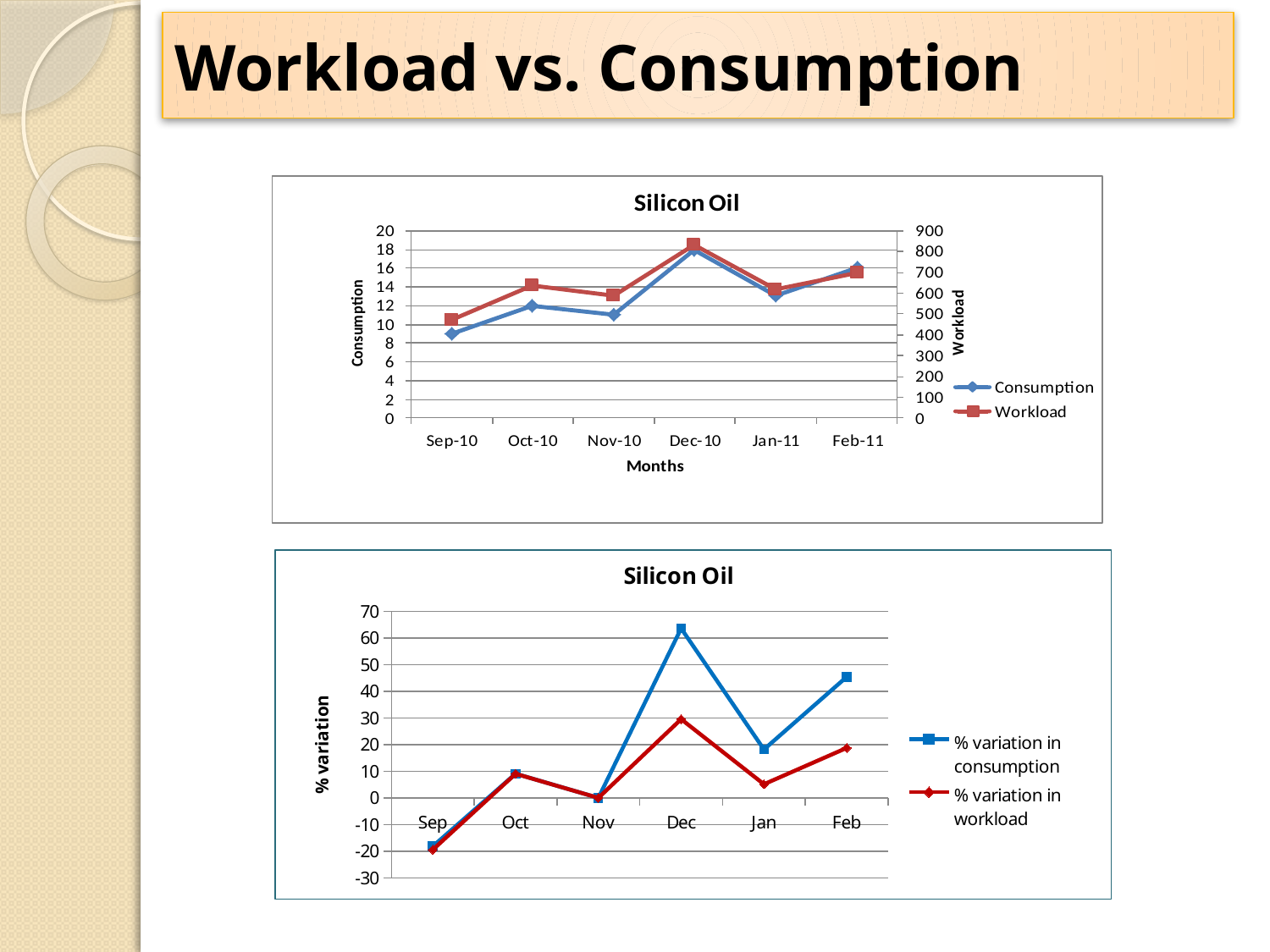
In the top chart, in which month is Consumption highest? Dec-10 What kind of chart is the top chart on the slide? line chart In the top chart, is Consumption higher in Oct-10 or in Jan-11? Jan-11 In the top chart, is the Consumption value for Dec-10 greater or less than 16? greater In the bottom chart, which series has the larger value in Feb, % variation in consumption or % variation in workload? % variation in consumption What is the label of the right-hand vertical axis of the top chart? Workload In the top chart, in which month is Workload lowest? Sep-10 How many months are plotted on the x axis of the top chart? 6 In the top chart, is the Workload value for Sep-10 greater or less than 500? less In the bottom chart, is the % variation in consumption for Dec greater or less than 60? greater In the bottom chart, in which month is the % variation in consumption highest? Dec How many series does the legend of the top chart list? 2